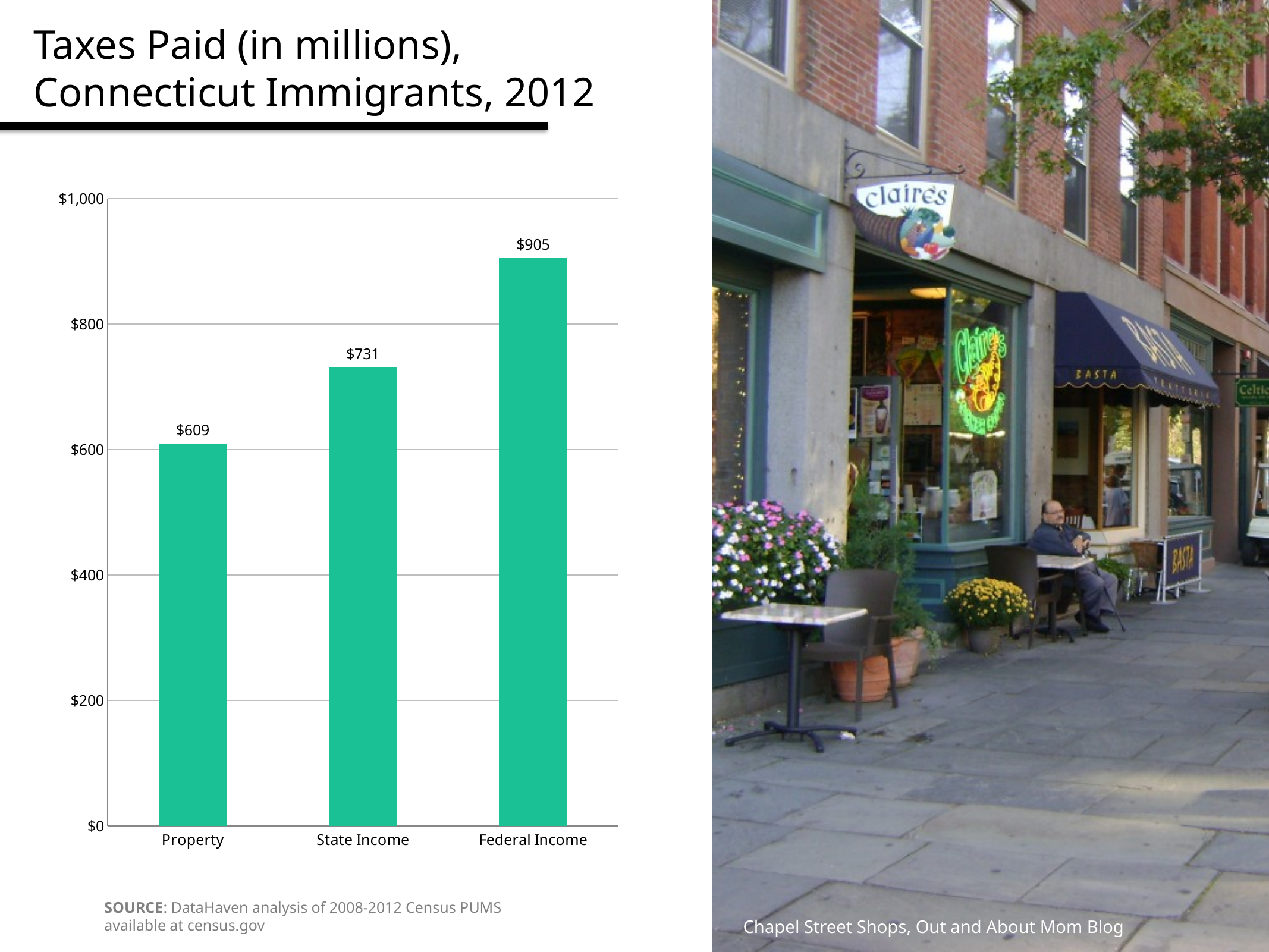
What is the value for Property taxes paid? $609 What is the difference between Federal Income and Property taxes paid? $296 Do the values rise or fall from left to right across the categories? Rise What is the value for State Income taxes paid? $731 What kind of chart is shown on the slide? Bar chart Which tax category has the highest value? Federal Income How many tax categories are shown in the chart? 3 Which is larger, State Income or Federal Income taxes paid? Federal Income What is the difference between State Income and Property taxes paid? $122 Which tax category has the lowest value? Property What is the value for Federal Income taxes paid? $905 Is the value for State Income greater or less than $800? less